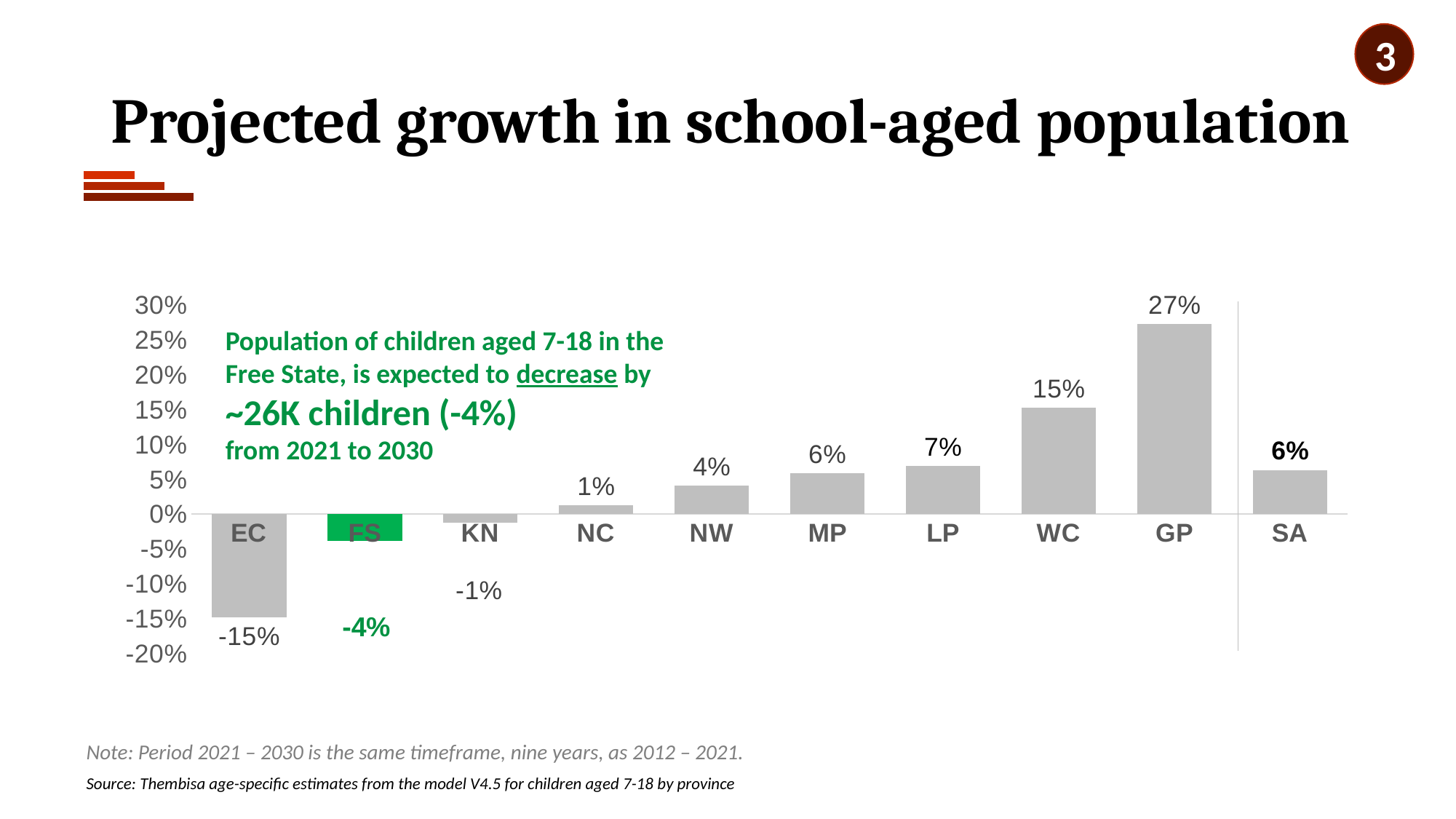
What is the projected growth value for FS? -4% How many categories are shown on the x axis? 10 Which province has the highest projected growth? GP Which province has the lowest projected growth? EC What is the difference between the values for GP and WC? 12 percentage points What is the projected growth value for GP? 27% What is the projected growth value for EC? -15% What is the projected growth value for SA? 6% Which is larger, the value for LP or the value for MP? LP Which bar is highlighted in green? FS Is the value for WC greater or less than 10%? greater What kind of chart is shown on the slide? bar chart